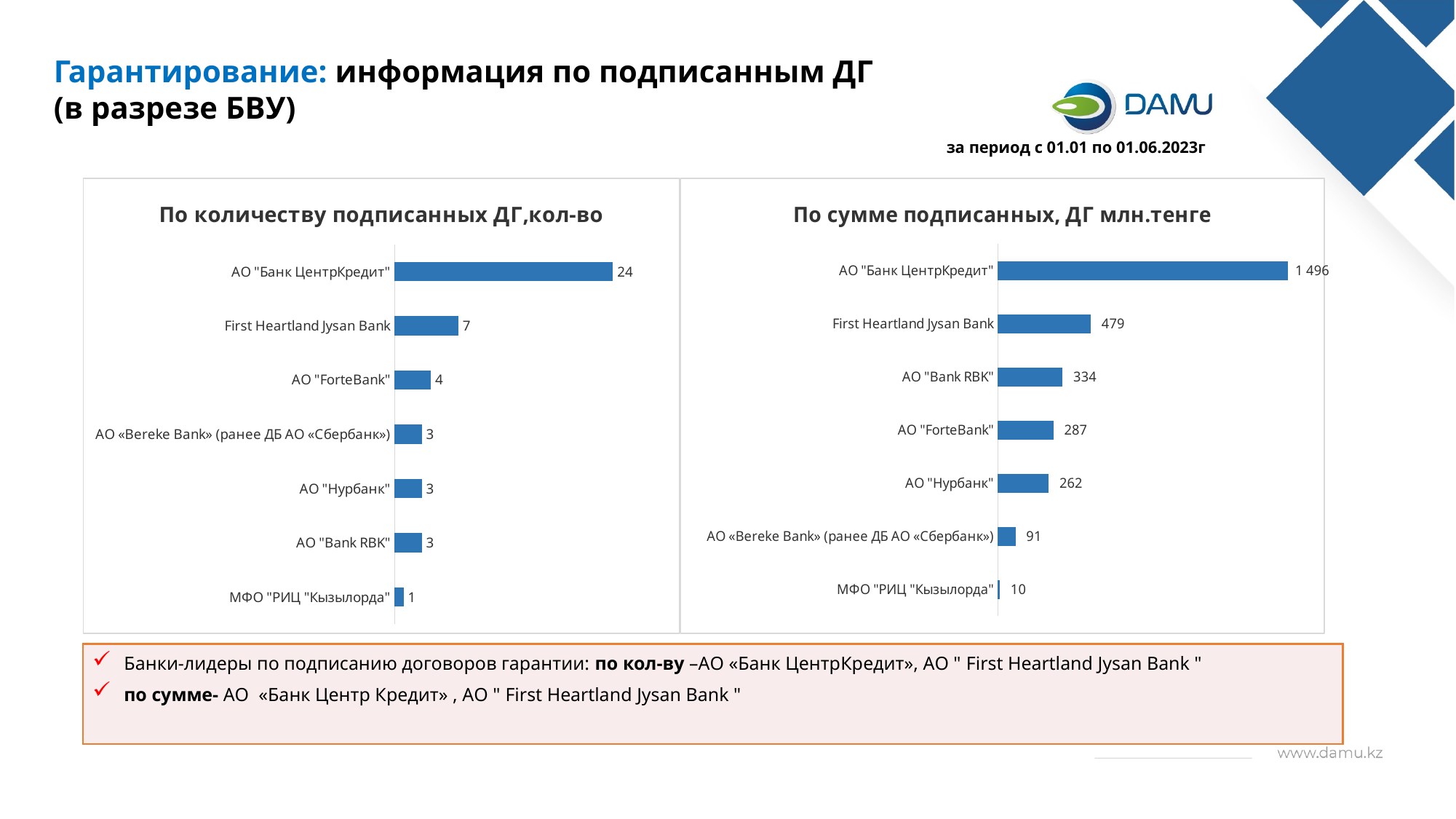
What type of chart is "По сумме подписанных, ДГ млн.тенге"? bar chart In the chart "По количеству подписанных ДГ,кол-во", what is the difference between АО "Банк ЦентрКредит" and First Heartland Jysan Bank? 17 In the chart "По количеству подписанных ДГ,кол-во", what is the value for АО "Банк ЦентрКредит"? 24 What is the title of the left chart on the slide? По количеству подписанных ДГ,кол-во In the chart "По количеству подписанных ДГ,кол-во", which bank has the lowest value? МФО "РИЦ "Кызылорда" In the chart "По сумме подписанных, ДГ млн.тенге", what is the value for АО «Bereke Bank» (ранее ДБ АО «Сбербанк»)? 91 How many banks are shown in the chart "По количеству подписанных ДГ,кол-во"? 7 In the chart "По сумме подписанных, ДГ млн.тенге", which is larger: АО "Bank RBK" or АО "ForteBank"? АО "Bank RBK" In the chart "По сумме подписанных, ДГ млн.тенге", which bank has the highest value? АО "Банк ЦентрКредит" In the chart "По сумме подписанных, ДГ млн.тенге", what is the value for First Heartland Jysan Bank? 479 In the chart "По сумме подписанных, ДГ млн.тенге", what is the difference between АО "ForteBank" and АО "Нурбанк"? 25 In the chart "По сумме подписанных, ДГ млн.тенге", what is the value for АО "Bank RBK"? 334